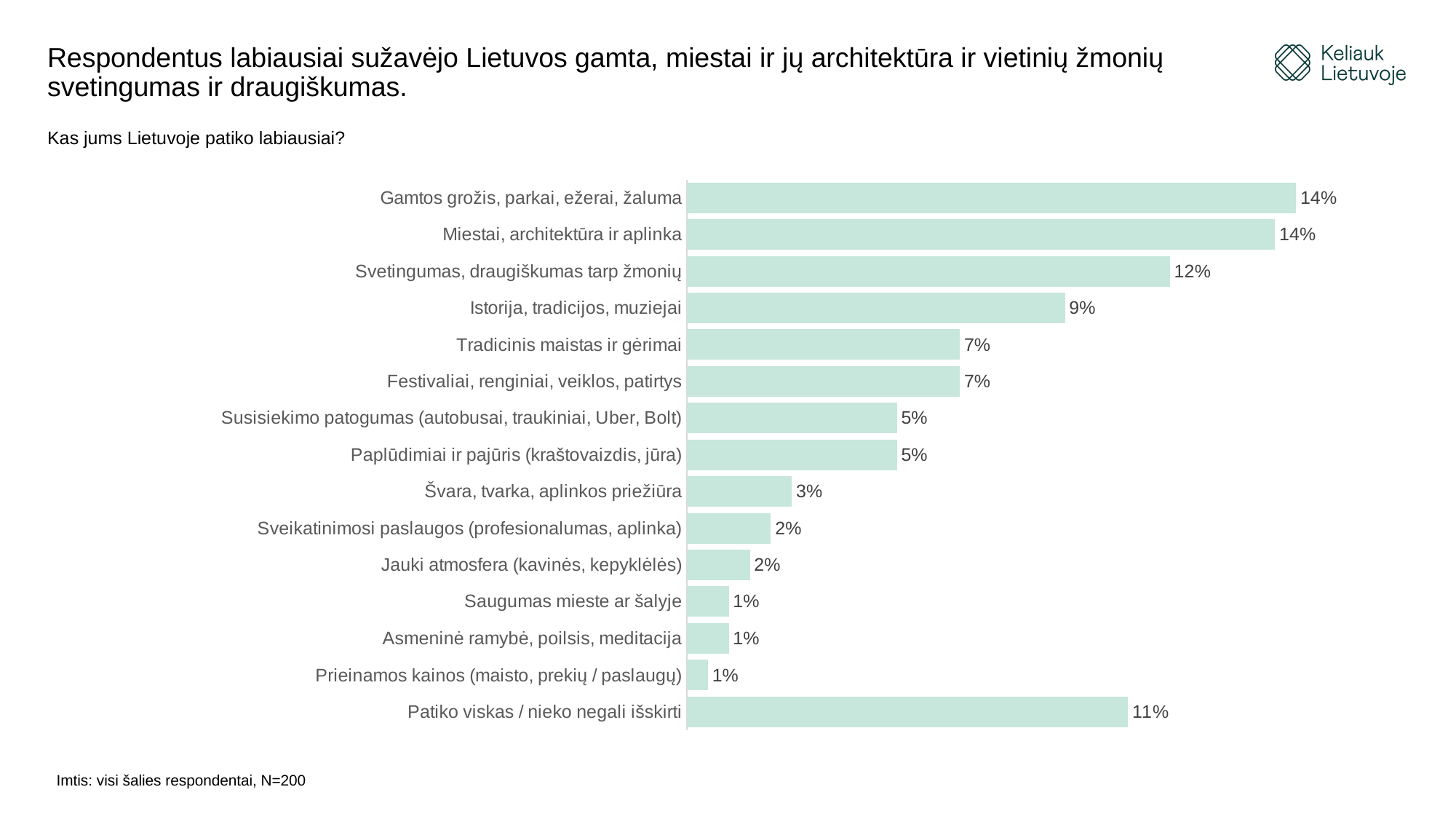
What is the difference between the values for "Svetingumas, draugiškumas tarp žmonių" and "Istorija, tradicijos, muziejai"? 3% Which has a larger value: "Tradicinis maistas ir gėrimai" or "Susisiekimo patogumas (autobusai, traukiniai, Uber, Bolt)"? Tradicinis maistas ir gėrimai What is the value for "Gamtos grožis, parkai, ežerai, žaluma"? 14% What is the value for "Istorija, tradicijos, muziejai"? 9% How many categories are shown in the chart? 15 What is the value for "Patiko viskas / nieko negali išskirti"? 11% Which has a larger value: "Patiko viskas / nieko negali išskirti" or "Istorija, tradicijos, muziejai"? Patiko viskas / nieko negali išskirti What is the difference between the values for "Gamtos grožis, parkai, ežerai, žaluma" and "Patiko viskas / nieko negali išskirti"? 3% What kind of chart is shown on the slide? Bar chart What question is the chart answering, as written above it? Kas jums Lietuvoje patiko labiausiai? What is the value for "Švara, tvarka, aplinkos priežiūra"? 3% What is the value for "Svetingumas, draugiškumas tarp žmonių"? 12%